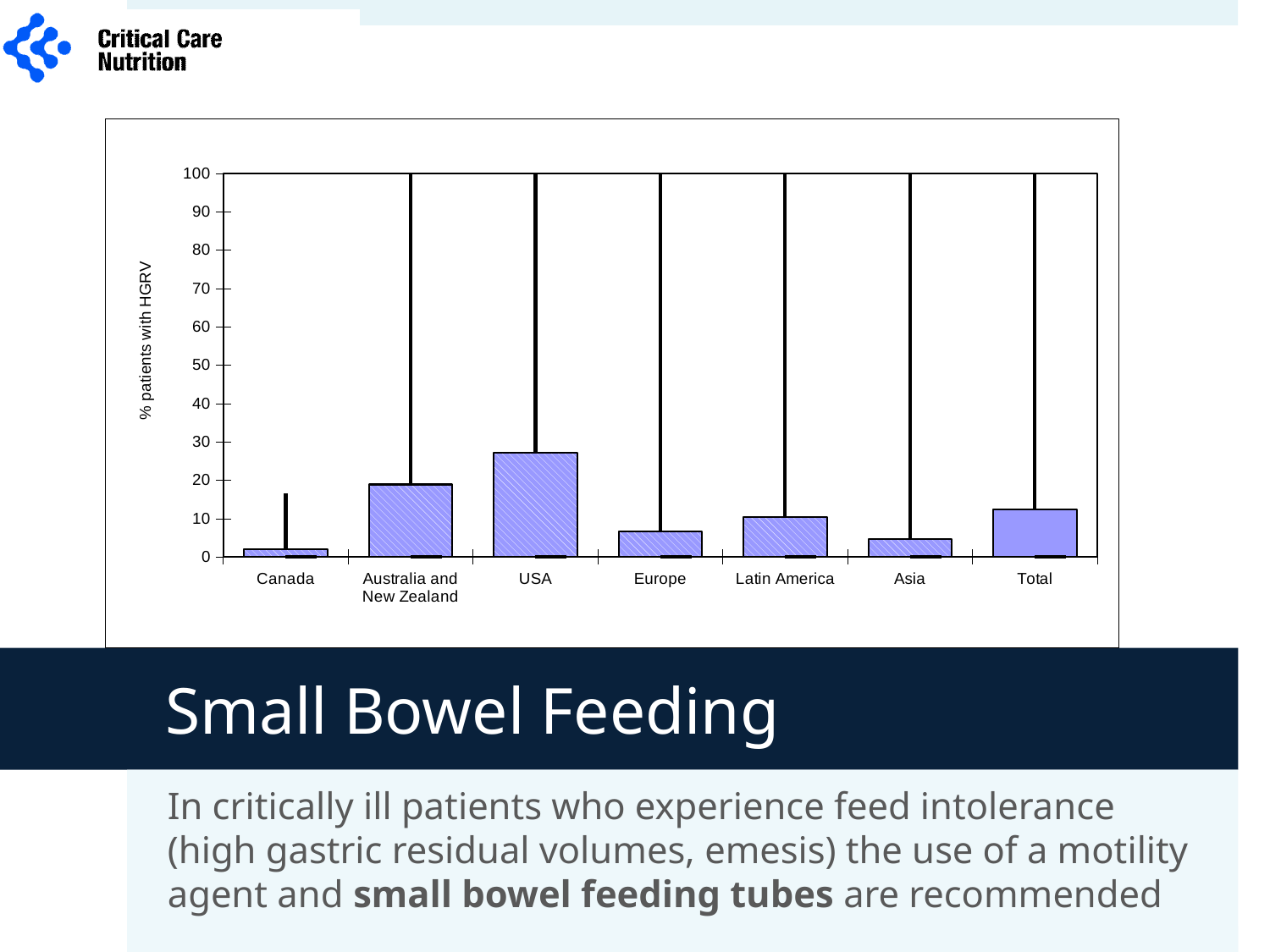
Is the value for Europe greater or less than 10? less What kind of chart is shown on the slide? bar chart Is the value for USA greater or less than 20? greater Is the value for Canada greater or less than 10? less What is the label of the y axis of the chart? % patients with HGRV Which has a higher bar, Australia and New Zealand or Asia? Australia and New Zealand How many categories are shown on the x axis of the chart? 7 Which category has the lowest bar in the chart? Canada What is the title shown on the slide below the chart? Small Bowel Feeding Which has a higher bar, USA or Europe? USA Which category has the highest bar in the chart? USA